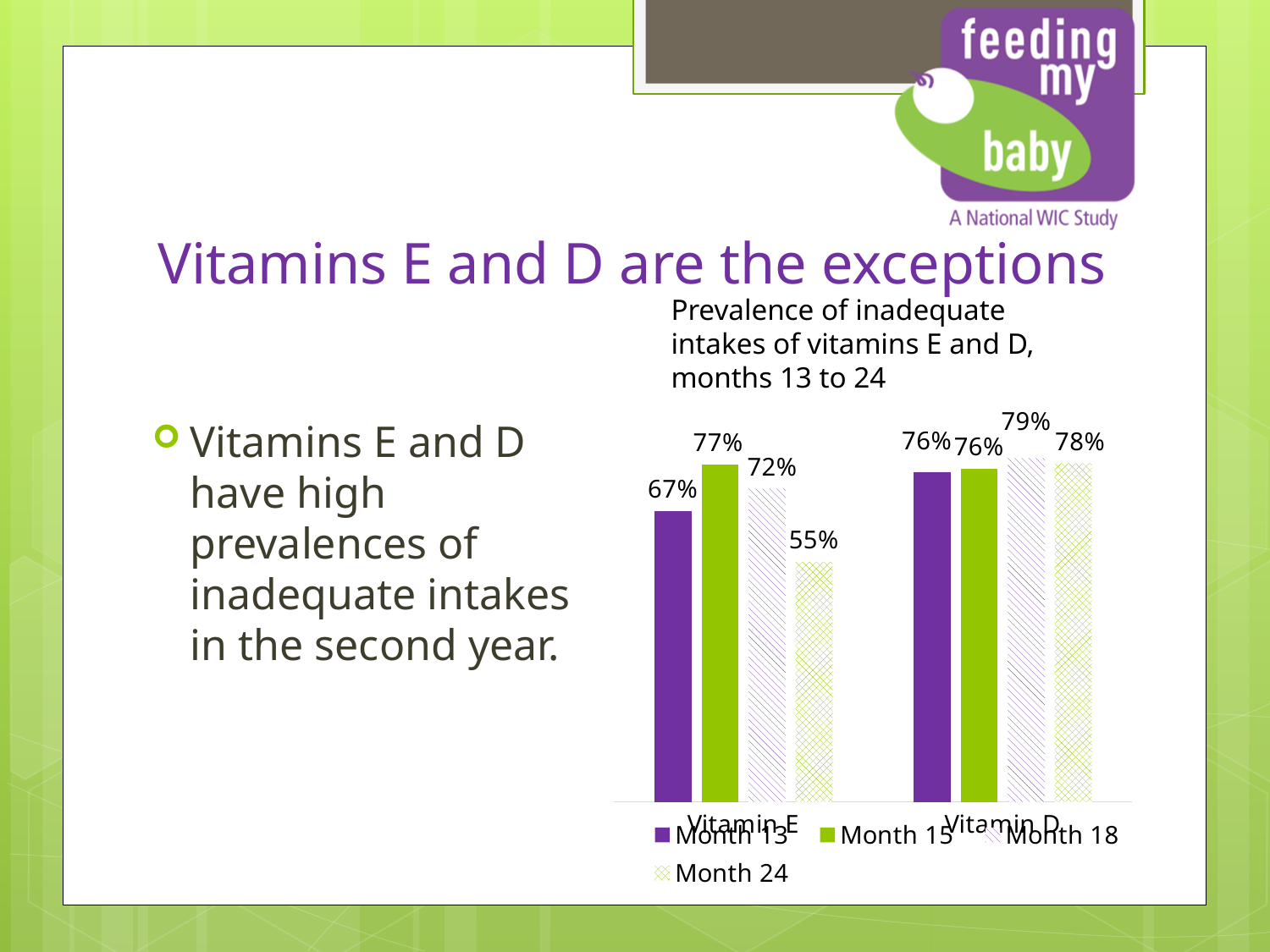
What is the prevalence of inadequate intake of Vitamin E at Month 13? 67% For Vitamin E, which month has the lowest prevalence of inadequate intake? Month 24 For Vitamin E, which month has the highest prevalence of inadequate intake? Month 15 Which is larger: the Vitamin D value at Month 13 or the Vitamin E value at Month 13? Vitamin D What is the prevalence of inadequate intake of Vitamin E at Month 24? 55% What is the title of the chart? Prevalence of inadequate intakes of vitamins E and D, months 13 to 24 What is the difference between the Vitamin E values at Month 15 and Month 24? 22 percentage points What kind of chart is shown on the slide? Bar chart How many vitamin categories are shown on the x axis? 2 How many series does the legend list? 4 What is the prevalence of inadequate intake of Vitamin D at Month 18? 79% What is the prevalence of inadequate intake of Vitamin D at Month 24? 78%